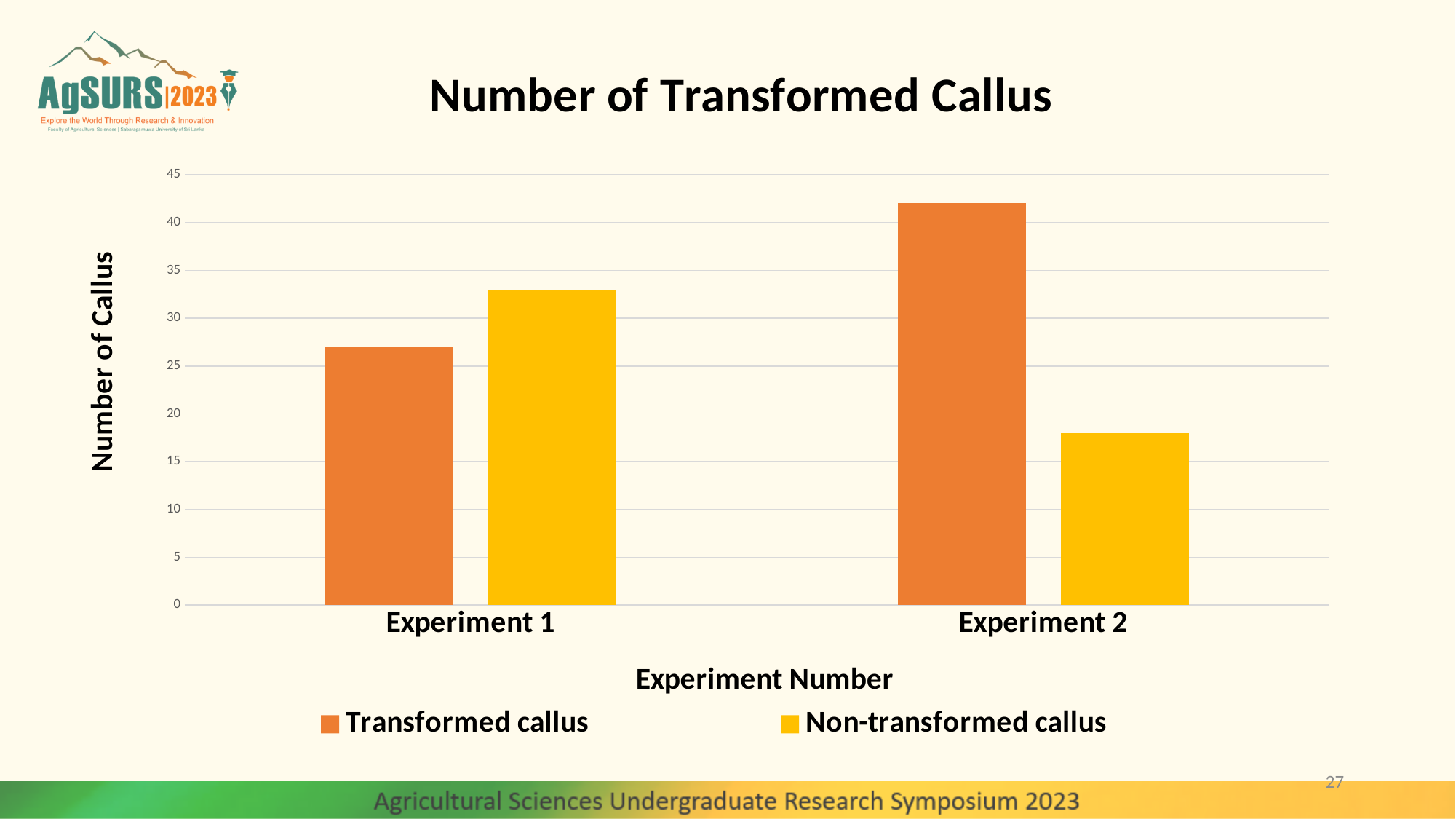
Is the Transformed callus value for Experiment 2 greater or less than 40? greater How many experiments are shown on the x axis? 2 Is the Transformed callus value for Experiment 1 greater or less than 25? greater Which experiment has the lowest Non-transformed callus value? Experiment 2 Does the Transformed callus value rise or fall from Experiment 1 to Experiment 2? rise How many series does the legend list? 2 In Experiment 1, which is larger: Transformed callus or Non-transformed callus? Non-transformed callus What is the title of the chart? Number of Transformed Callus In Experiment 2, which is larger: Transformed callus or Non-transformed callus? Transformed callus Which series has the tallest bar in the chart? Transformed callus What type of chart is shown on the slide? bar chart Is the Non-transformed callus value for Experiment 2 greater or less than 20? less